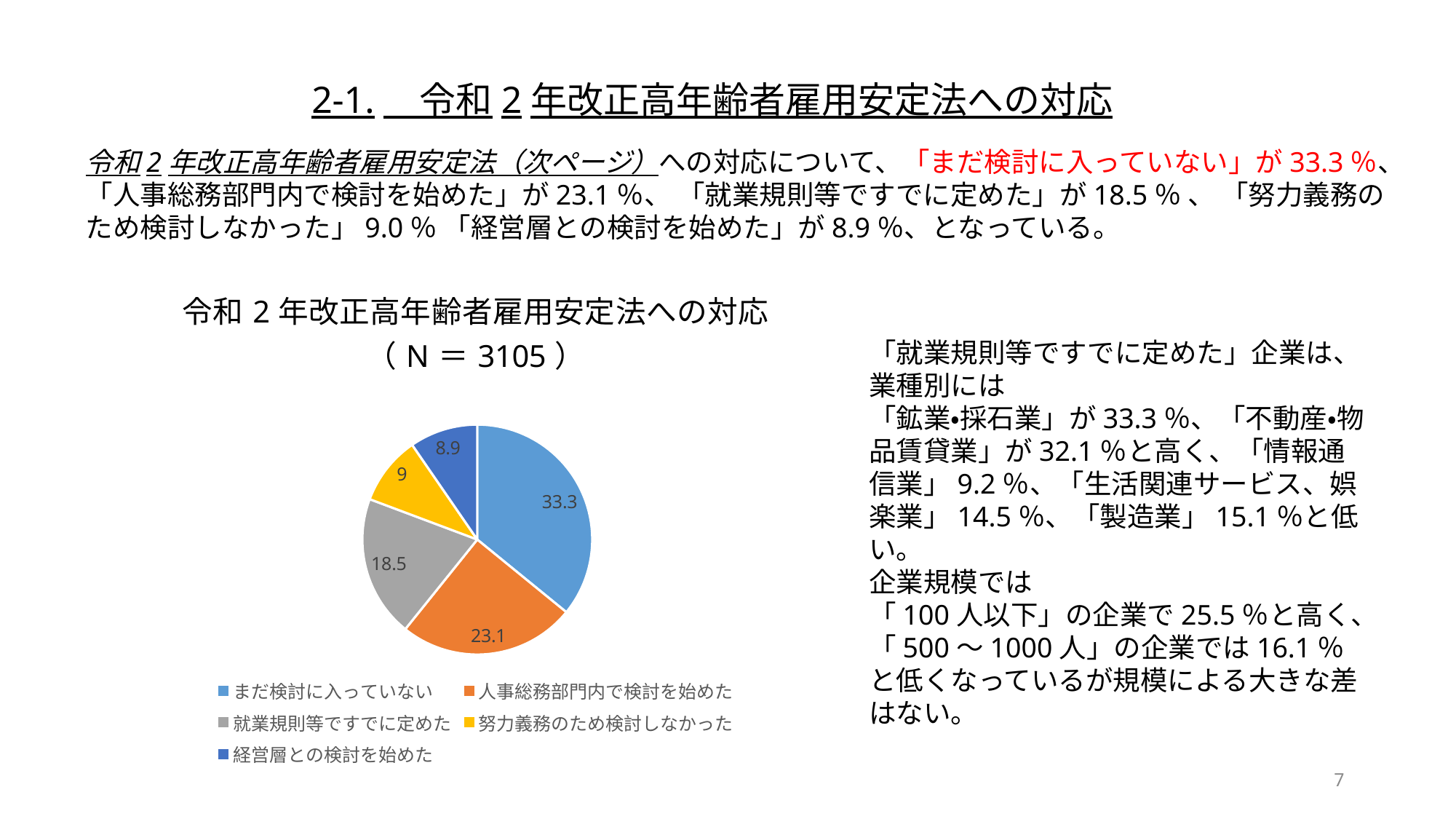
Which category has the largest slice in the pie chart? まだ検討に入っていない What is the value shown for 「経営層との検討を始めた」 in the pie chart? 8.9 What is the value shown for 「人事総務部門内で検討を始めた」 in the pie chart? 23.1 How many entries does the chart legend list? 5 What is the N (sample size) shown in the chart title? 3105 What kind of chart is shown on the slide? Pie chart What is the value shown for 「努力義務のため検討しなかった」 in the pie chart? 9 What is the difference between the values for 「まだ検討に入っていない」 and 「人事総務部門内で検討を始めた」? 10.2 How many slices does the pie chart have? 5 Which is larger: the slice for 「人事総務部門内で検討を始めた」 or the slice for 「就業規則等ですでに定めた」? 人事総務部門内で検討を始めた What is the value shown for 「まだ検討に入っていない」 in the pie chart? 33.3 What is the value shown for 「就業規則等ですでに定めた」 in the pie chart? 18.5